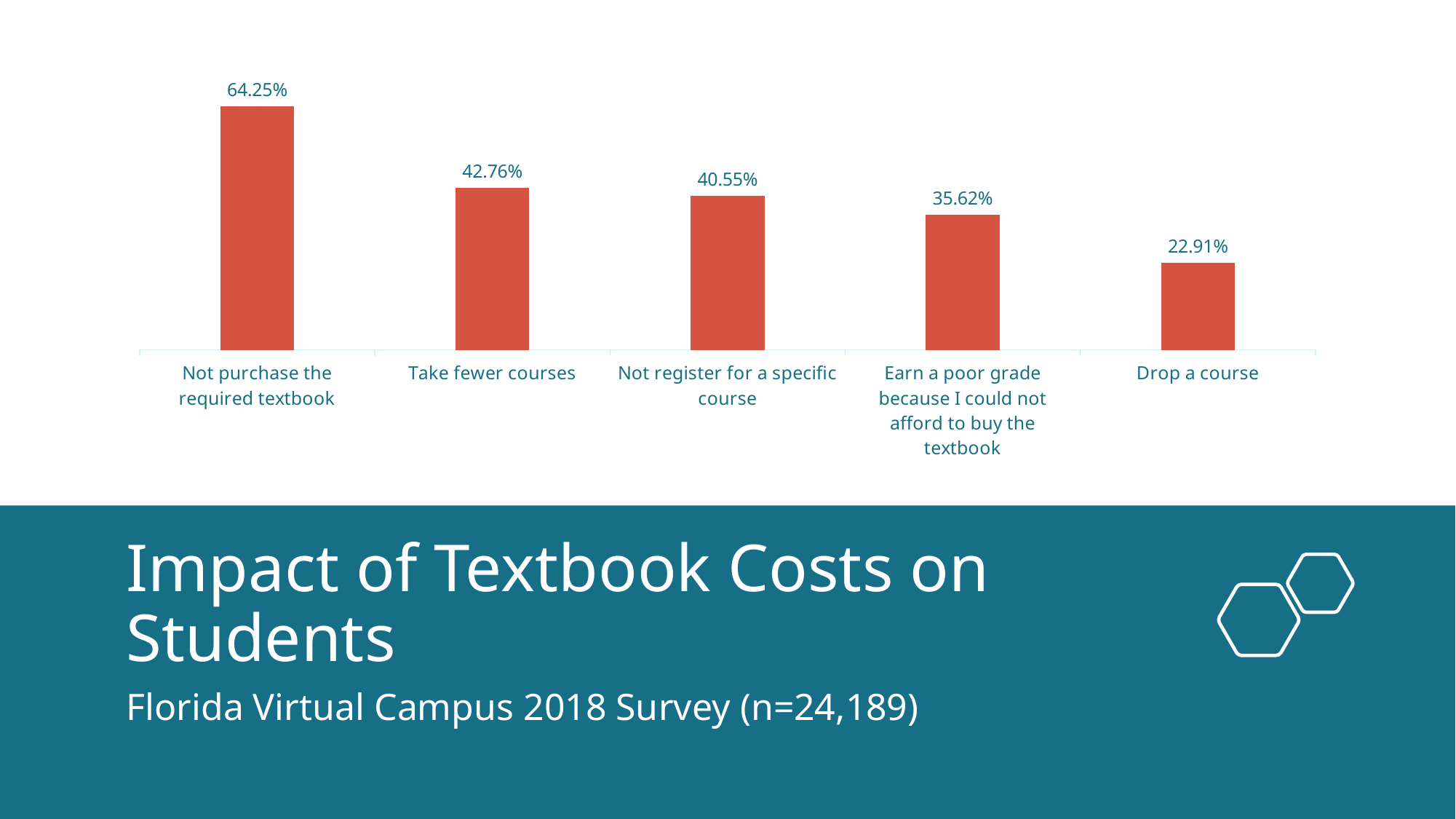
What is the value shown for "Drop a course"? 22.91% How many categories are shown in the chart? 5 Which category has the highest value? Not purchase the required textbook What percentage of students reported they would not purchase the required textbook? 64.25% Which is larger: "Earn a poor grade because I could not afford to buy the textbook" or "Drop a course"? Earn a poor grade because I could not afford to buy the textbook What is the difference between "Take fewer courses" and "Not register for a specific course"? 2.21% Which category has the lowest value? Drop a course What percentage is shown for "Earn a poor grade because I could not afford to buy the textbook"? 35.62% What is the value shown for "Take fewer courses"? 42.76% What is the difference between "Not purchase the required textbook" and "Drop a course"? 41.34% What kind of chart is shown on the slide? Bar chart Do the values rise or fall from left to right across the categories? Fall